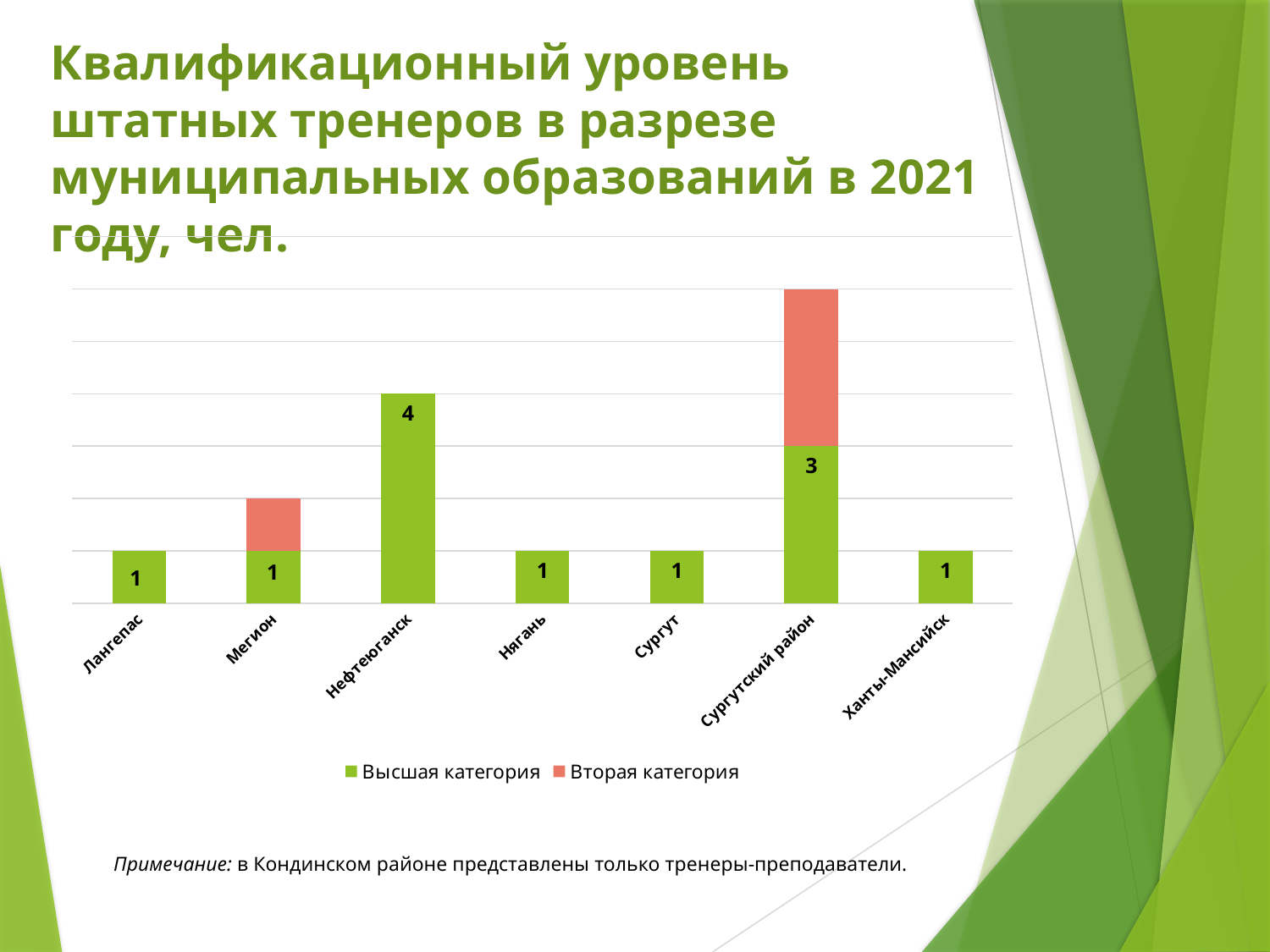
What kind of chart is shown on the slide? Stacked bar chart What is the value of Высшая категория for Нефтеюганск? 4 What is the value of Высшая категория for Лангепас? 1 Which category has the tallest stacked bar overall? Сургутский район How many categories are shown on the x axis? 7 Which has a larger Высшая категория value, Нефтеюганск or Сургутский район? Нефтеюганск What is the value of Высшая категория for Сургутский район? 3 How many series does the legend list? 2 What is the difference between the Высшая категория values for Нефтеюганск and Сургутский район? 1 What is the value of Высшая категория for Ханты-Мансийск? 1 Which categories have a Вторая категория segment in their bar? Мегион and Сургутский район Which category has the highest value for Высшая категория? Нефтеюганск